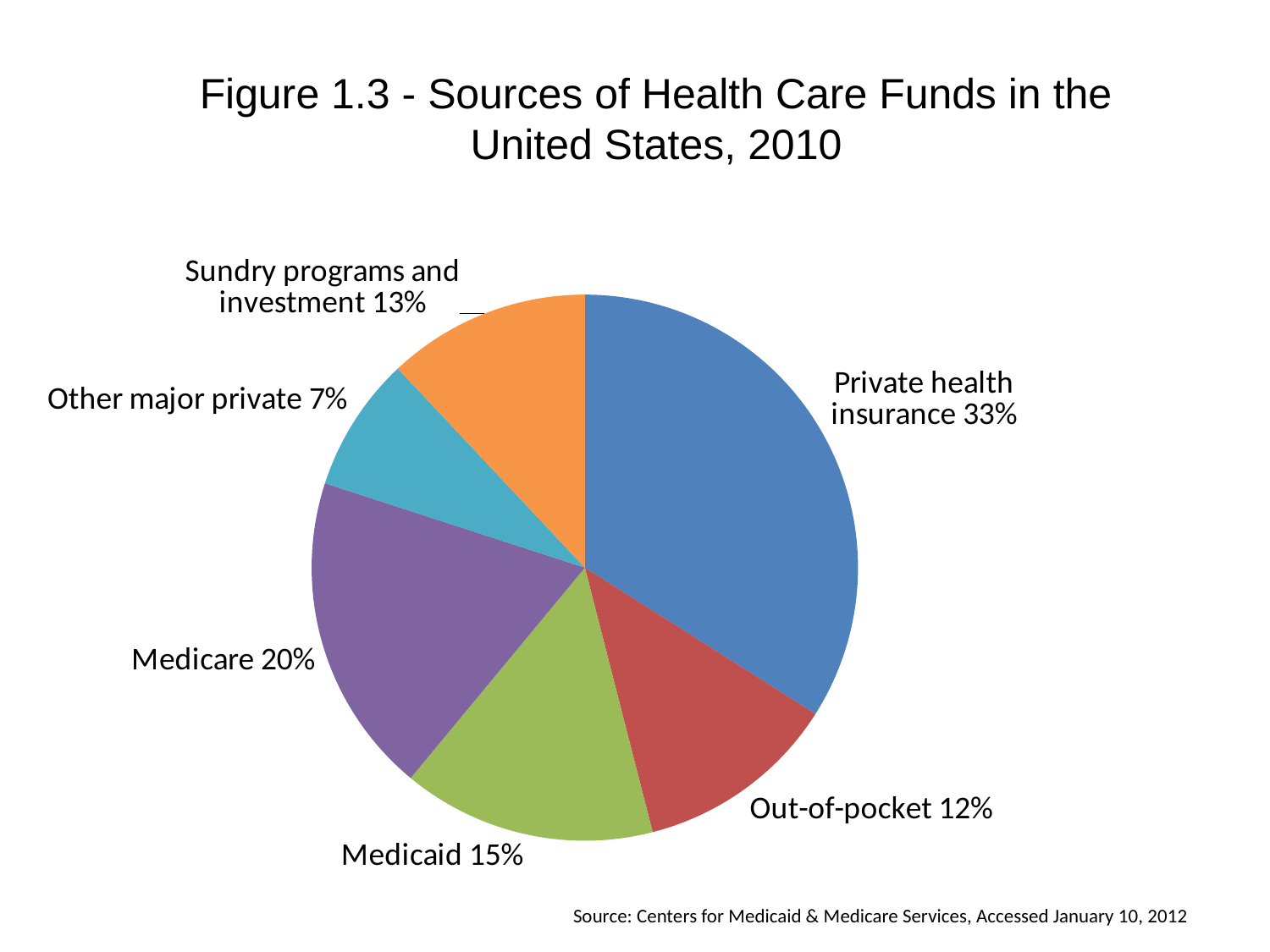
What share of health care funds comes from private health insurance? 33% What share of health care funds comes from Medicaid? 15% What share of health care funds comes from out-of-pocket payments? 12% What kind of chart is shown on the slide? Pie chart What is the difference in percentage points between the Medicare share and the Medicaid share? 5 Which source of health care funds has the smallest share? Other major private Which is larger, the share for Medicaid or the share for out-of-pocket? Medicaid What share of health care funds comes from Medicare? 20% How many slices does the pie chart have? 6 Which source of health care funds has the largest share? Private health insurance What share of health care funds comes from sundry programs and investment? 13% What is the title of the chart? Figure 1.3 - Sources of Health Care Funds in the United States, 2010